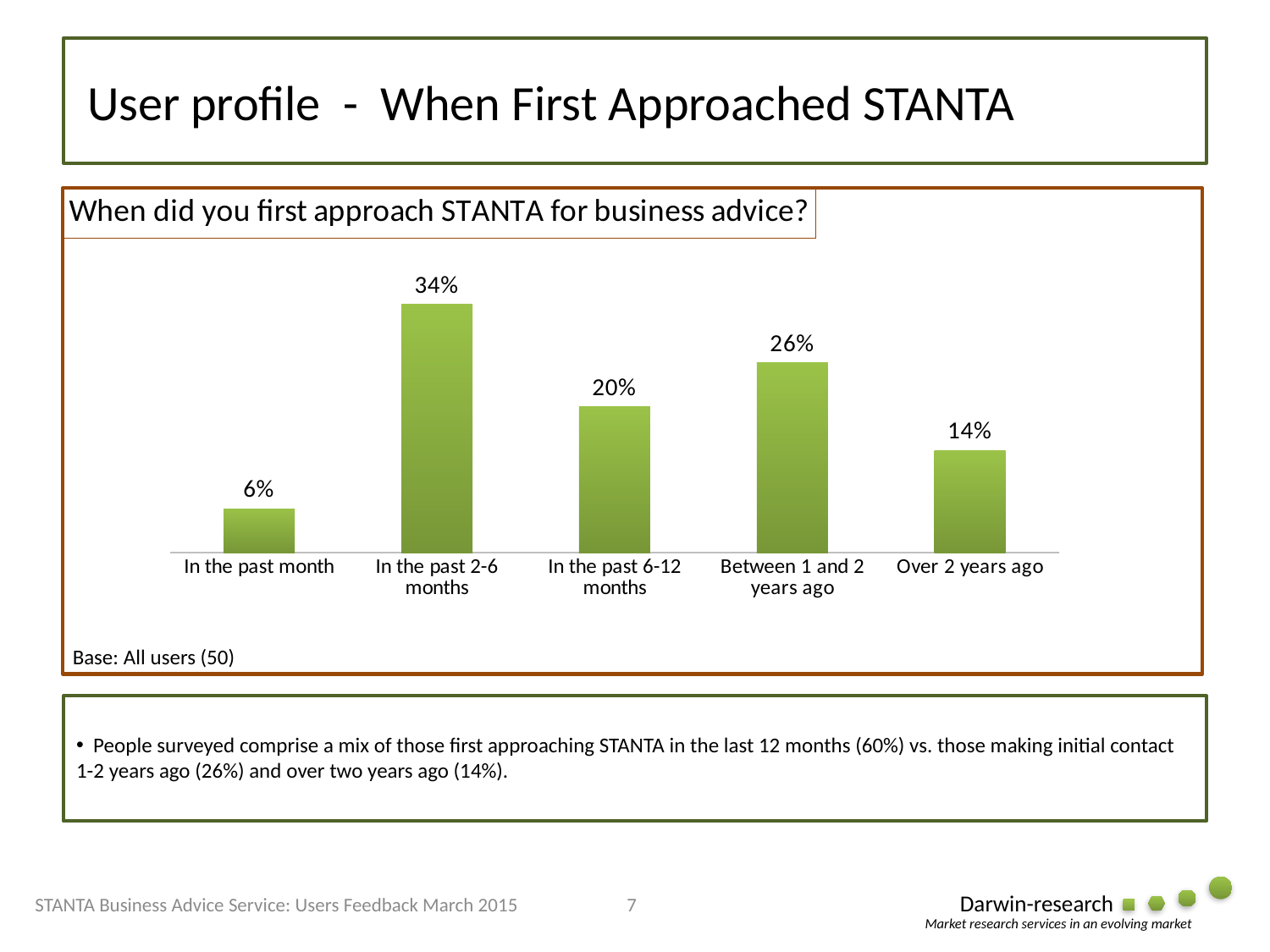
What is the difference in percentage points between 'In the past 2-6 months' and 'In the past 6-12 months'? 14 percentage points What percentage of users first approached STANTA in the past 2-6 months? 34% What is the title of the chart? When did you first approach STANTA for business advice? What percentage of users first approached STANTA in the past month? 6% Which category has the lowest percentage? In the past month Which is larger: the value for 'Between 1 and 2 years ago' or 'Over 2 years ago'? Between 1 and 2 years ago What kind of chart is shown on the slide? Bar chart How many categories are shown in the chart? 5 Which category has the highest percentage? In the past 2-6 months What percentage of users first approached STANTA over 2 years ago? 14% What percentage of users first approached STANTA between 1 and 2 years ago? 26% What is the base (number of respondents) stated for the chart? All users (50)